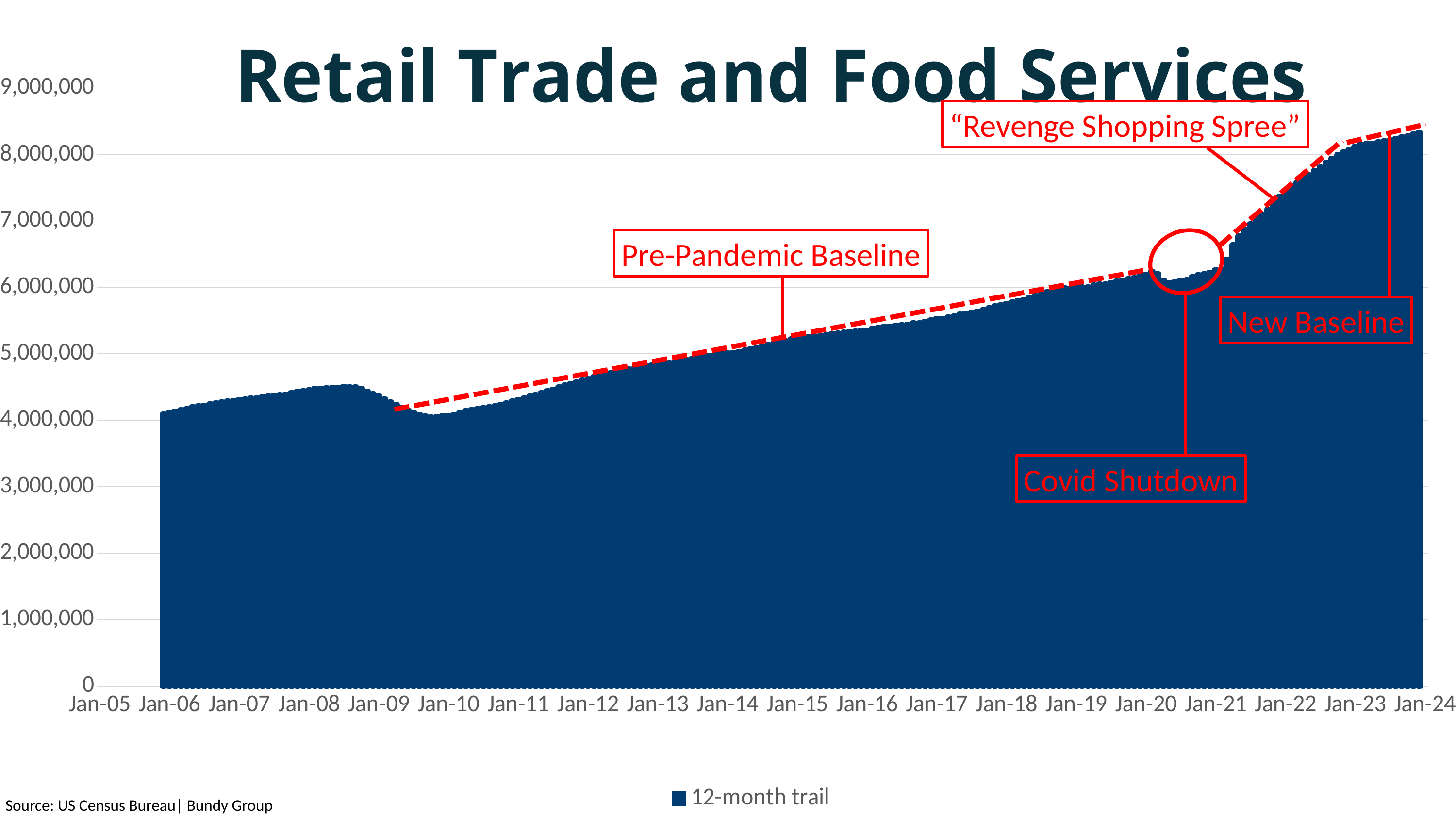
Overall, do the values rise or fall from Jan-06 to Jan-24? Rise What kind of chart is shown on the slide? Bar chart Is the value at Jan-10 greater or less than 5,000,000? less Is the value at Jan-22 greater or less than 7,000,000? greater What is the title of the chart? Retail Trade and Food Services Which is larger, the value at Jan-24 or the value at Jan-06? Jan-24 Which is larger, the value at Jan-09 or the value at Jan-10? Jan-09 What is the name of the series shown in the legend? 12-month trail At which x-axis label does the series reach its highest value? Jan-24 Is the value at Jan-20 greater or less than 6,000,000? greater How many series does the legend list? 1